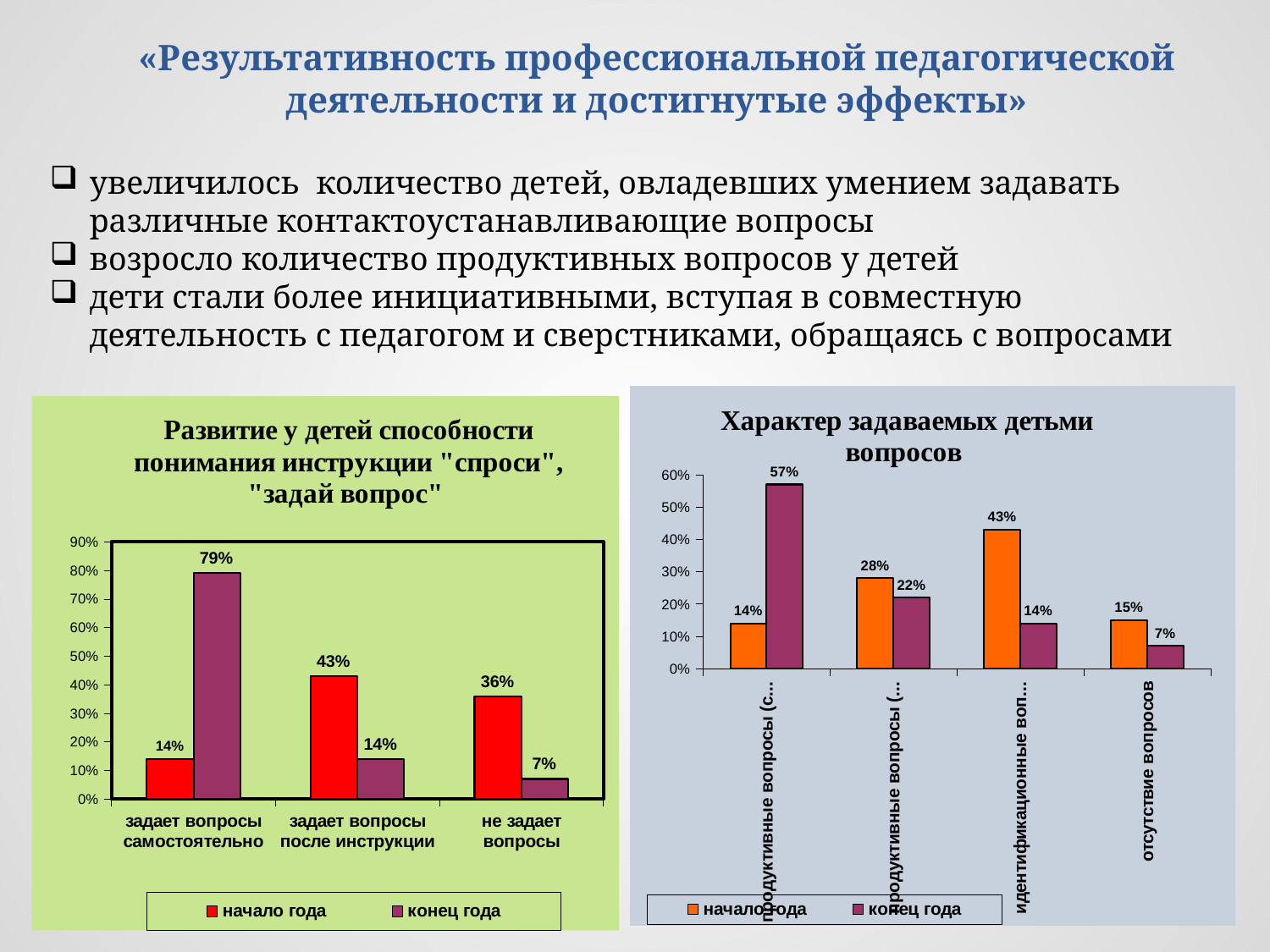
In the right chart "Характер задаваемых детьми вопросов", which category has the highest "конец года" value? The first category, продуктивные вопросы (с… (57%) In the right chart "Характер задаваемых детьми вопросов", what is the value for "конец года" in the category "отсутствие вопросов"? 7% What type of chart is the left chart "Развитие у детей способности понимания инструкции"? bar chart In the left chart, which category has the highest value for "начало года"? задает вопросы после инструкции In the left chart, how many series does the legend list? 2 In the left chart, what is the value for "конец года" in the category "задает вопросы самостоятельно"? 79% In the left chart, what is the difference between the "конец года" and "начало года" values for "задает вопросы самостоятельно"? 65% In the left chart, what is the value for "начало года" in the category "не задает вопросы"? 36% In the right chart "Характер задаваемых детьми вопросов", how many categories are shown on the x axis? 4 In the right chart "Характер задаваемых детьми вопросов", is the "конец года" value for the first category (продуктивные вопросы) greater or less than 50%? greater In the right chart "Характер задаваемых детьми вопросов", what is the value for "начало года" in the category "отсутствие вопросов"? 15% In the left chart, how many categories are shown on the x axis? 3